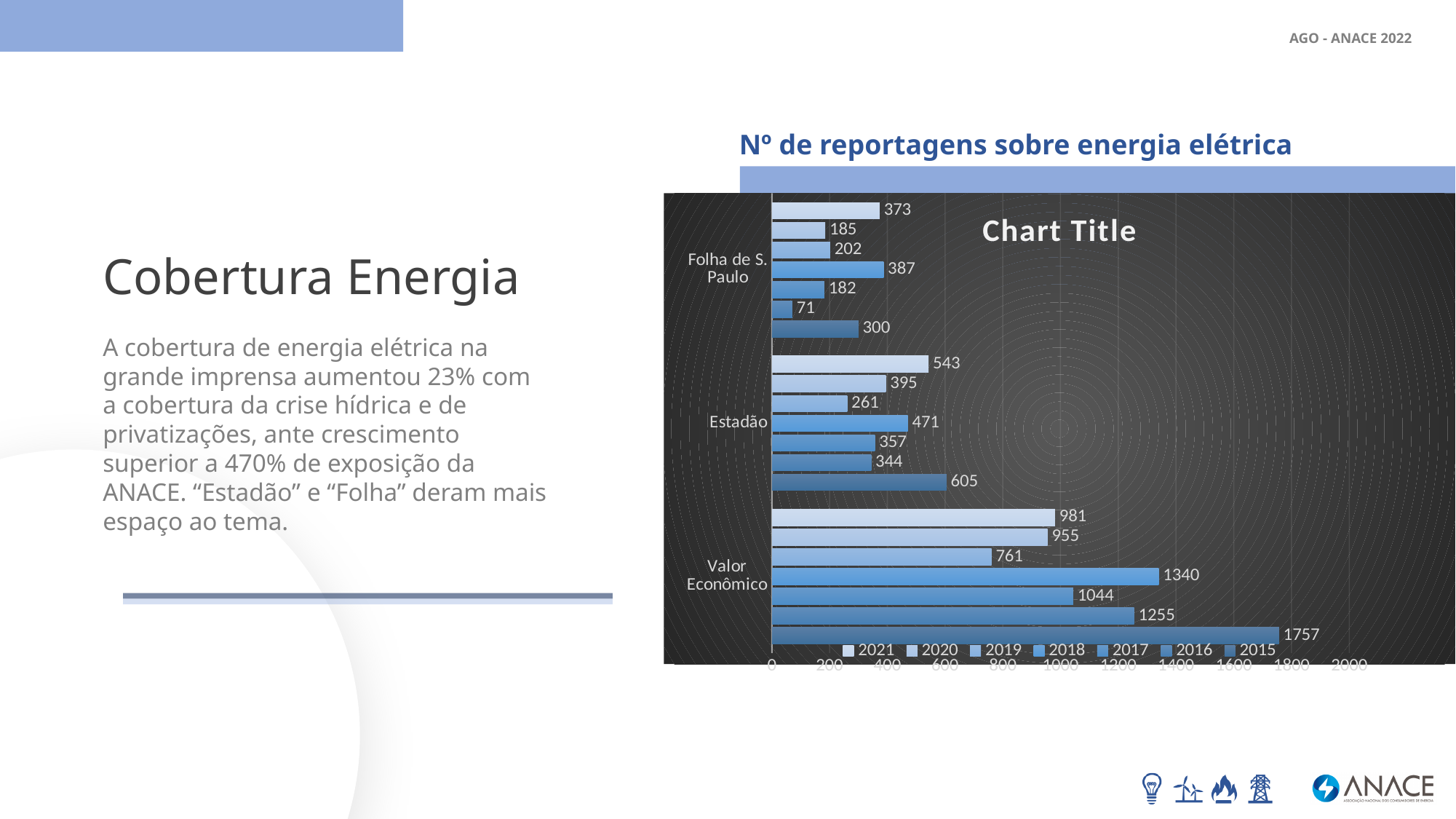
How many categories (newspapers) are shown on the chart's vertical axis? 3 Is the 2017 value for Valor Econômico greater or less than 1000? greater What is the value of the 2016 bar for Folha de S. Paulo? 71 Which newspaper has the largest single bar on the chart? Valor Econômico What is the value of the 2021 bar for Estadão? 543 What title is printed above the chart on the slide? Nº de reportagens sobre energia elétrica What is the difference between the 2015 and 2021 values for Valor Econômico? 776 What kind of chart is shown on the slide? bar chart What is the value of the 2015 bar for Valor Econômico? 1757 How many series does the chart legend list? 7 What is the smallest value shown for Folha de S. Paulo? 71 Which is larger: the 2018 value for Estadão or the 2018 value for Folha de S. Paulo? Estadão